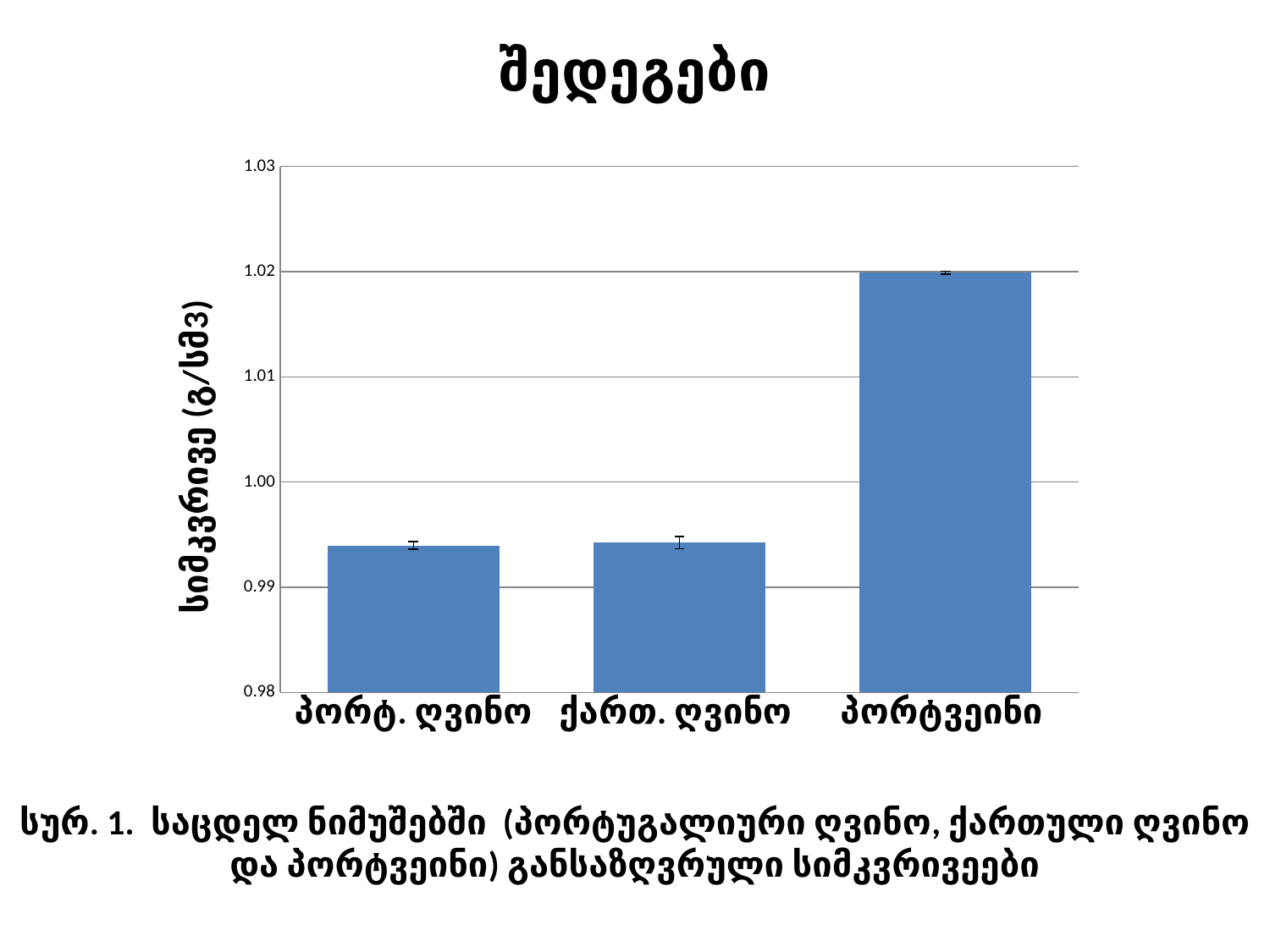
Which is larger, the value for პორტვეინი or the value for ქართ. ღვინო? პორტვეინი Is the value for პორტ. ღვინო greater or less than 0.99? greater Is the value for პორტვეინი greater or less than 1.01? greater What is the title of the slide above the chart? შედეგები What is the value for პორტვეინი in the chart? 1.02 Which category has the highest value in the chart? პორტვეინი Is the value for ქართ. ღვინო greater or less than 1.00? less What is the label of the y axis of the chart? სიმკვრივე (გ/სმ3) What kind of chart is shown on the slide? bar chart How many categories are shown on the x axis of the chart? 3